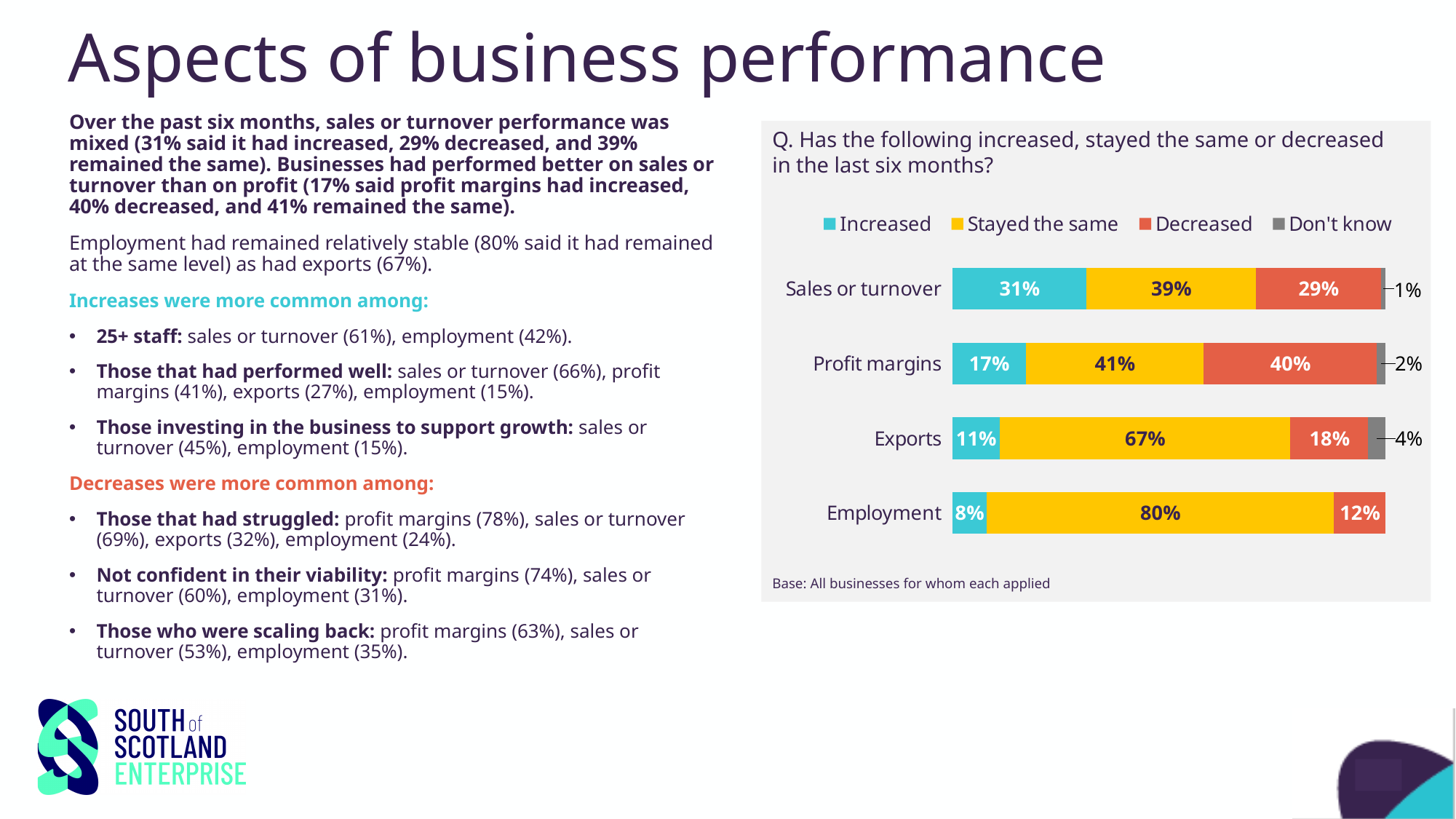
How many series does the chart legend list? 4 What is the difference between the 'Decreased' percentages for profit margins and sales or turnover? 11% How many categories are shown in the chart? 4 What percentage of businesses said sales or turnover had increased in the last six months? 31% What percentage of businesses said profit margins had decreased? 40% Which category has the highest 'Stayed the same' percentage? Employment What type of chart is shown on the slide? Stacked bar chart Which colour represents 'Decreased' in the chart? Red/orange Which category has the lowest 'Increased' percentage? Employment What percentage of businesses said exports had stayed the same? 67% What is the 'Don't know' percentage for exports? 4% Which is larger: the 'Increased' percentage for sales or turnover or for profit margins? Sales or turnover